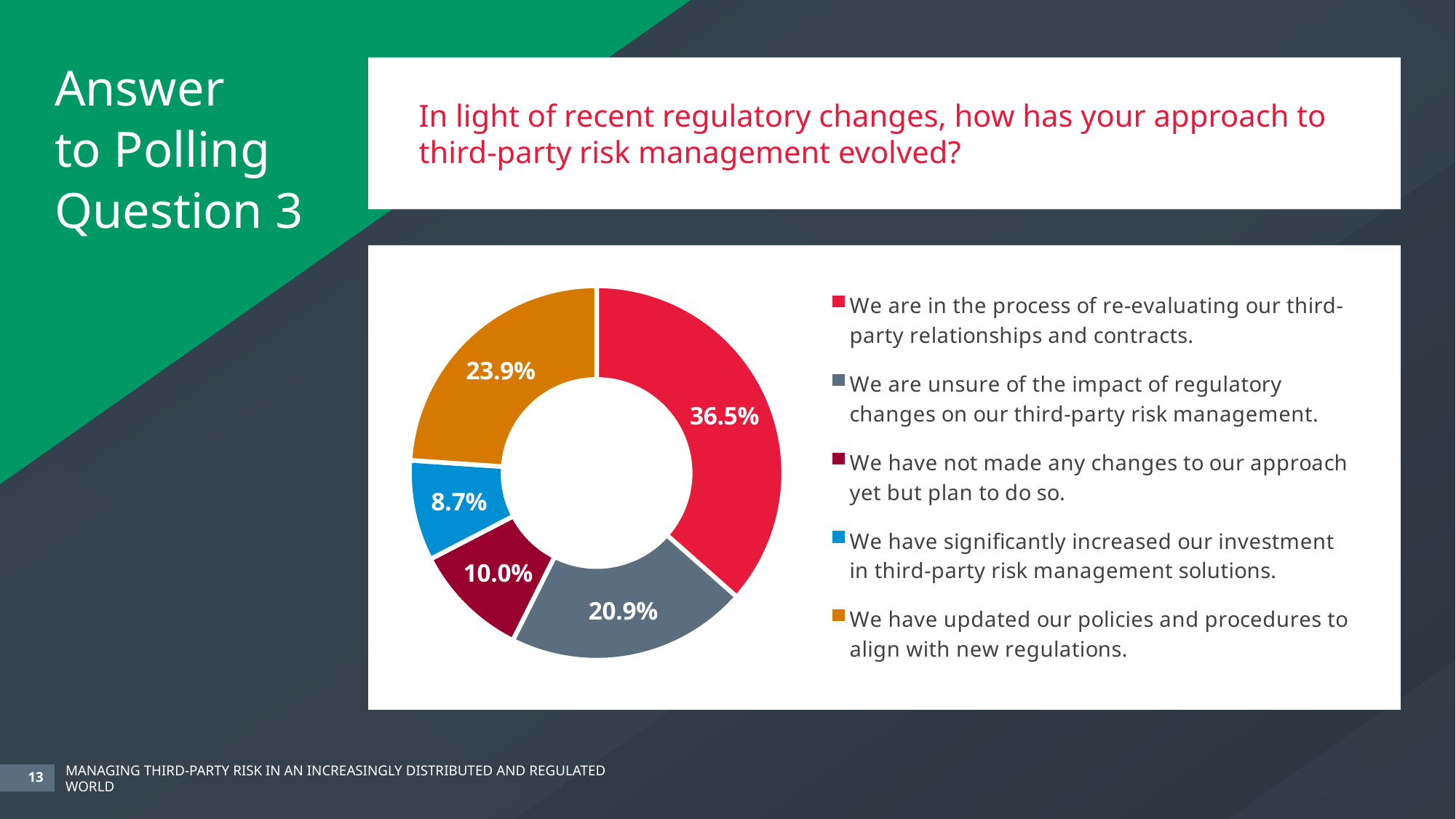
What percentage of respondents said they are in the process of re-evaluating their third-party relationships and contracts? 36.5% What percentage of respondents said they have significantly increased their investment in third-party risk management solutions? 8.7% Which is larger: the share that are unsure of the impact of regulatory changes or the share that have updated their policies and procedures? We have updated our policies and procedures to align with new regulations. What percentage of respondents said they have updated their policies and procedures to align with new regulations? 23.9% Which response received the smallest share of respondents? We have significantly increased our investment in third-party risk management solutions. What type of chart is shown on the slide? Pie chart (doughnut) What percentage of respondents said they have not made any changes to their approach yet but plan to do so? 10.0% What is the difference in percentage points between the share that are re-evaluating third-party relationships and contracts and the share that have updated policies and procedures? 12.6 What colour is the slice representing respondents who have not made any changes to their approach yet but plan to do so? Dark red Which response received the largest share of respondents? We are in the process of re-evaluating our third-party relationships and contracts. What percentage of respondents said they are unsure of the impact of regulatory changes on their third-party risk management? 20.9% How many response options are shown in the chart? 5